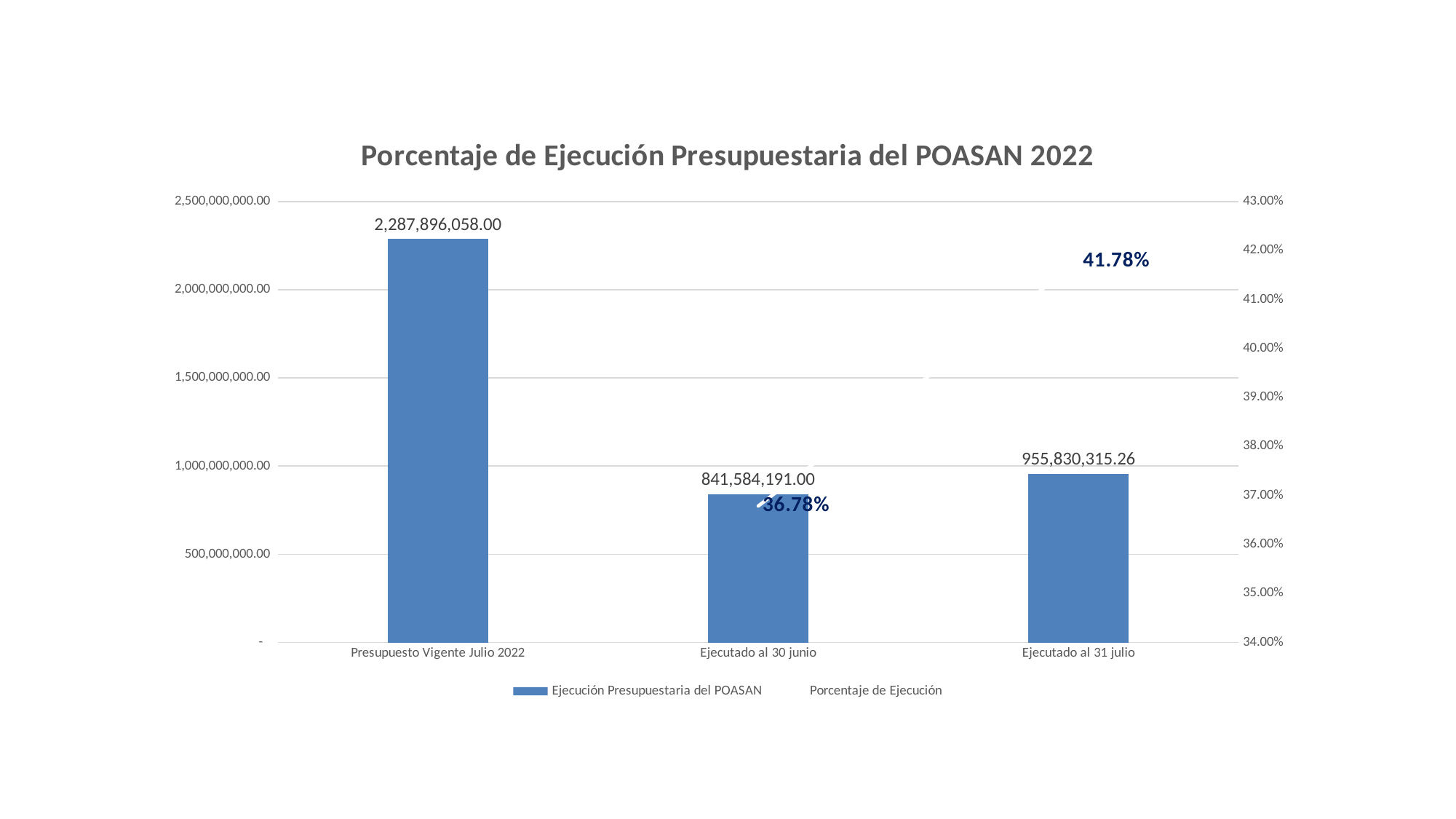
What is the Porcentaje de Ejecución shown for Ejecutado al 30 junio? 36.78% What is the value of the bar for Ejecutado al 30 junio? 841,584,191.00 Which category has the highest bar? Presupuesto Vigente Julio 2022 What is the value of the bar for Ejecutado al 31 julio? 955,830,315.26 Which category has the lowest bar? Ejecutado al 30 junio What type of chart is shown on the slide? bar chart How many series does the legend list? 2 What is the difference between the bar values for Ejecutado al 31 julio and Ejecutado al 30 junio? 114,246,124.26 What is the title of the chart? Porcentaje de Ejecución Presupuestaria del POASAN 2022 How many categories are shown on the x axis? 3 What is the Porcentaje de Ejecución shown for Ejecutado al 31 julio? 41.78% What is the value of the bar for Presupuesto Vigente Julio 2022? 2,287,896,058.00